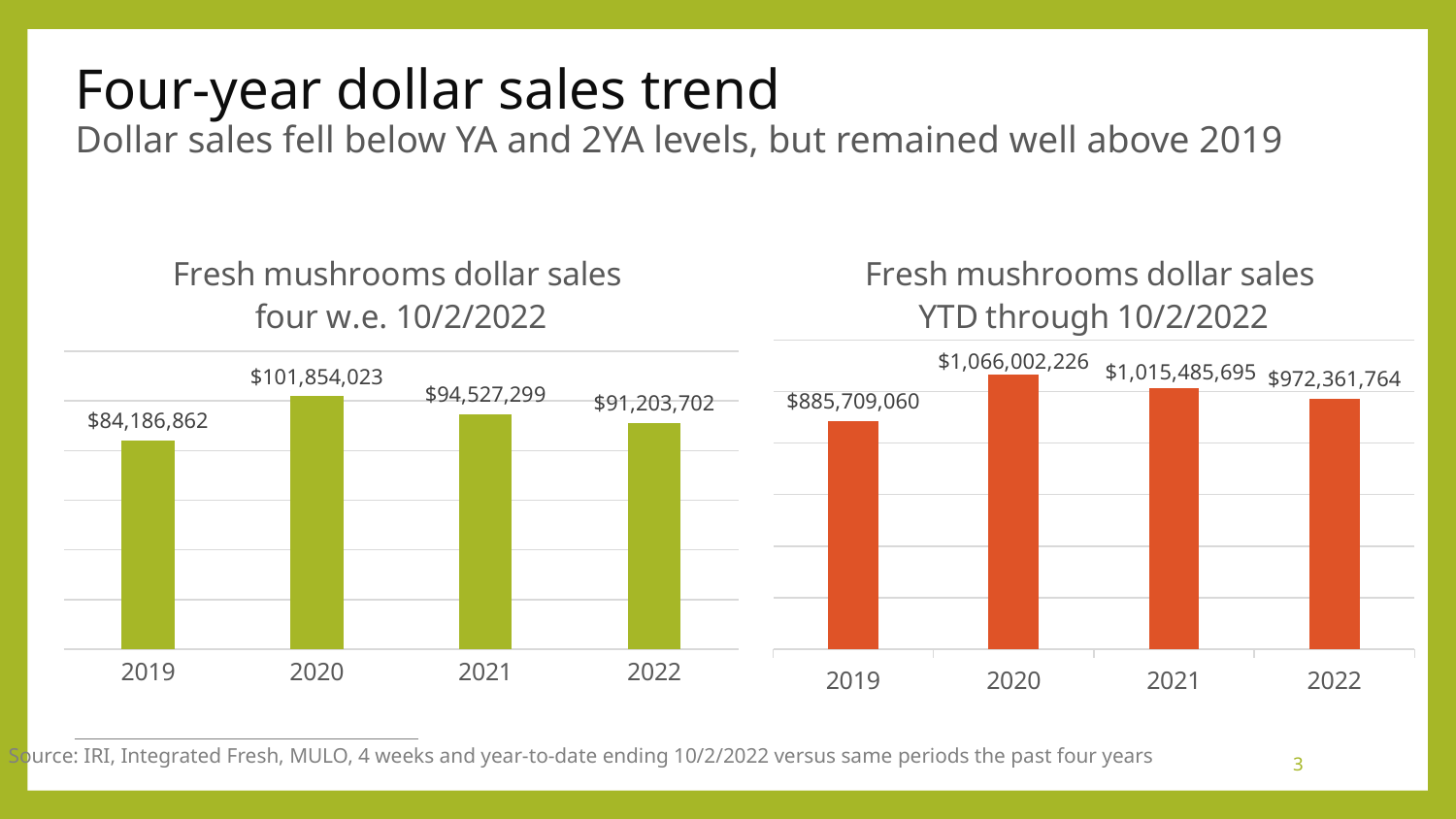
In the 'Fresh mushrooms dollar sales YTD through 10/2/2022' chart, do the values rise or fall from 2020 to 2022? Fall In the 'Fresh mushrooms dollar sales YTD through 10/2/2022' chart, which year has the lowest value? 2019 In the 'Fresh mushrooms dollar sales YTD through 10/2/2022' chart, what is the difference between the 2020 and 2022 values? $93,640,462 In the 'Fresh mushrooms dollar sales YTD through 10/2/2022' chart, what is the value for 2019? $885,709,060 In the 'Fresh mushrooms dollar sales four w.e. 10/2/2022' chart, which is larger, the value for 2021 or the value for 2022? 2021 In the 'Fresh mushrooms dollar sales four w.e. 10/2/2022' chart, what is the difference between the 2020 and 2019 values? $17,667,161 In the 'Fresh mushrooms dollar sales four w.e. 10/2/2022' chart, what is the value for 2022? $91,203,702 What kind of chart is the 'Fresh mushrooms dollar sales four w.e. 10/2/2022' chart? Bar chart In the 'Fresh mushrooms dollar sales four w.e. 10/2/2022' chart, what is the value for 2019? $84,186,862 How many years are shown in the 'Fresh mushrooms dollar sales YTD through 10/2/2022' chart? 4 In the 'Fresh mushrooms dollar sales YTD through 10/2/2022' chart, what is the value for 2021? $1,015,485,695 In the 'Fresh mushrooms dollar sales four w.e. 10/2/2022' chart, which year has the highest value? 2020